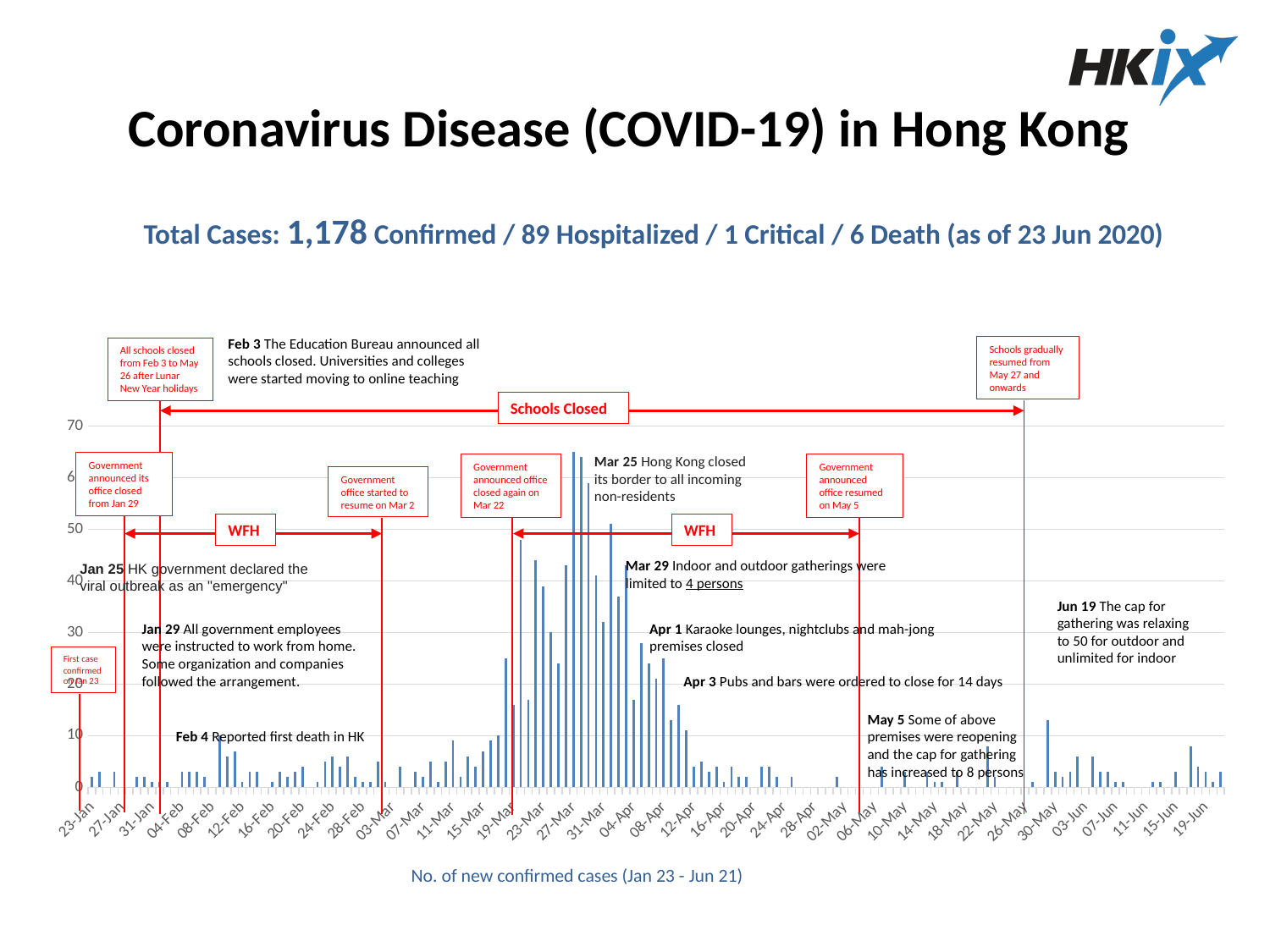
Is the value for 12-Feb greater or less than 20? less What is the highest value shown on the chart's vertical axis? 70 Do the daily new confirmed cases rise or fall between 07-Mar and 27-Mar? rise What is the caption below the chart? No. of new confirmed cases (Jan 23 - Jun 21) Which is larger, the number of new confirmed cases on 27-Mar or on 27-Jan? 27-Mar Is the value for 23-Jan greater or less than 10? less Is the value for 03-Jun greater or less than 10? less What kind of chart is used to show the number of new confirmed cases? Bar chart Do the daily new confirmed cases rise or fall between 31-Mar and 28-Apr? fall In which month does the highest daily number of new confirmed cases occur? March